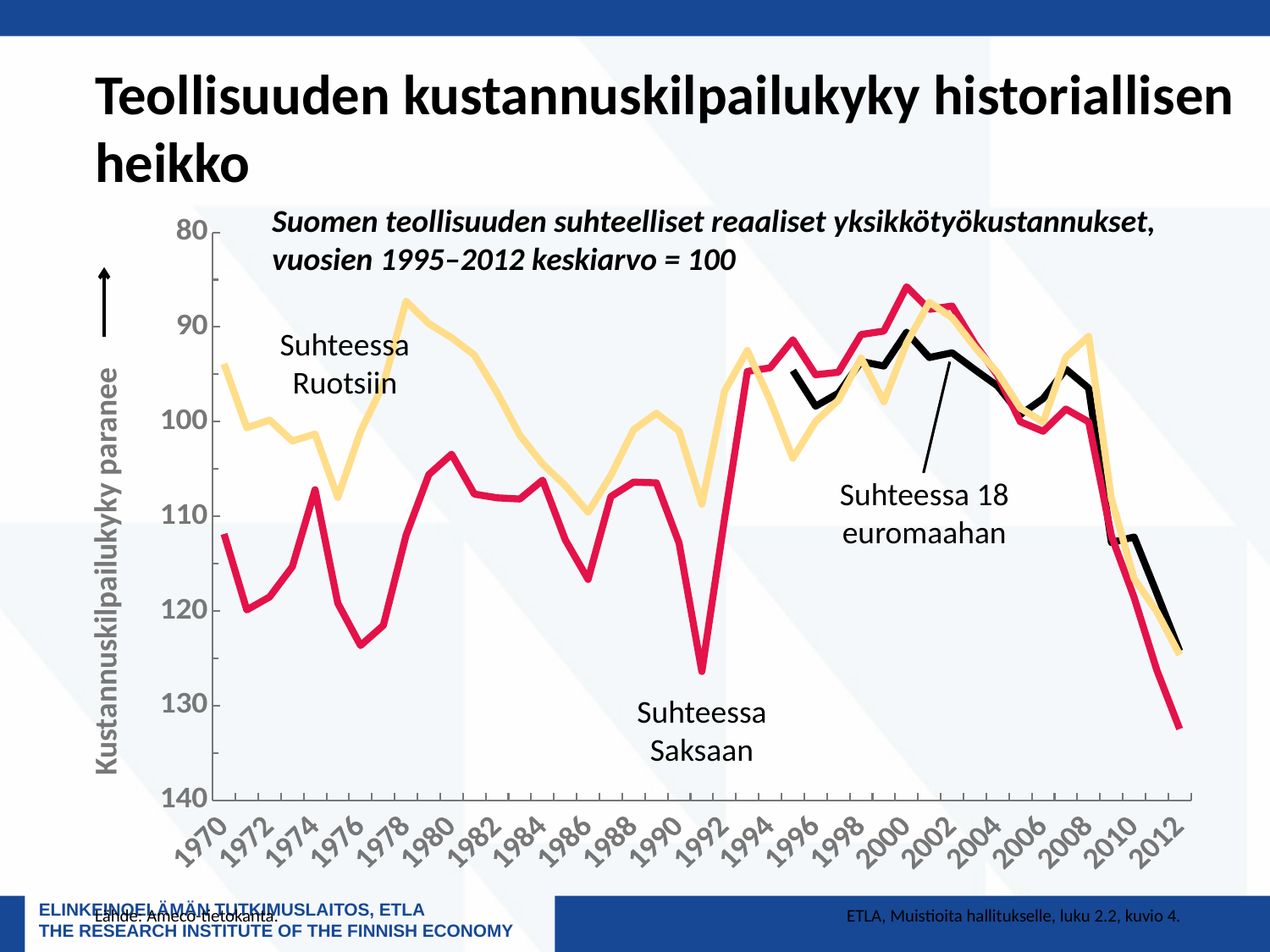
Is the value of the 'Suhteessa Ruotsiin' line in 1978 greater or less than 90? less Is the value of the 'Suhteessa Saksaan' line in 2012 greater or less than 120? greater In 1978, which line has the larger value: 'Suhteessa Ruotsiin' or 'Suhteessa Saksaan'? Suhteessa Saksaan In 2012, which line has the larger value: 'Suhteessa Saksaan' or 'Suhteessa Ruotsiin'? Suhteessa Saksaan What is the title of the chart? Suomen teollisuuden suhteelliset reaaliset yksikkötyökustannukset, vuosien 1995–2012 keskiarvo = 100 How many series are plotted on the chart? 3 What kind of chart is shown on the slide? line chart Is the value of the 'Suhteessa 18 euromaahan' line in 2012 greater or less than 120? greater What colour is the line labelled 'Suhteessa Saksaan'? red Do the values of the 'Suhteessa Saksaan' line rise or fall from 2008 to 2012? rise